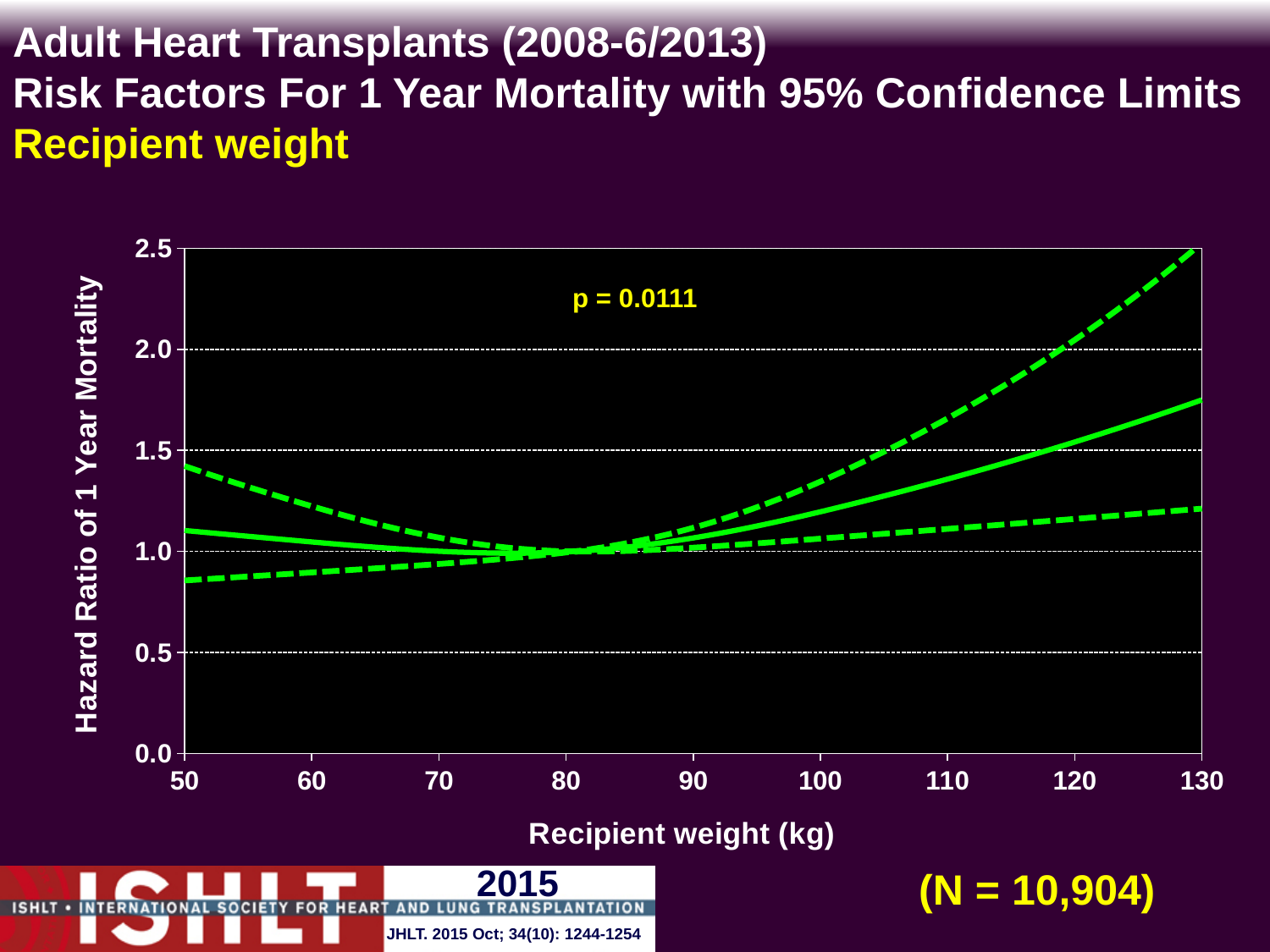
How many lines are plotted on the chart? 3 Is the hazard ratio on the solid line at a recipient weight of 130 kg greater or less than 1.5? greater At a recipient weight of 130 kg, which is larger: the upper dashed confidence limit or the solid line? the upper dashed confidence limit Is the hazard ratio on the solid line larger at a recipient weight of 130 kg or at 50 kg? 130 kg Is the lower dashed confidence limit at a recipient weight of 50 kg greater or less than 1.0? less What kind of chart is shown on the slide? line chart Is the hazard ratio on the solid line at a recipient weight of 50 kg greater or less than 1.5? less Does the solid hazard ratio line rise or fall as recipient weight increases from 50 kg to 80 kg? falls What p-value is printed on the chart? p = 0.0111 What is the label of the x axis? Recipient weight (kg) Does the solid hazard ratio line rise or fall as recipient weight increases from 90 kg to 130 kg? rises